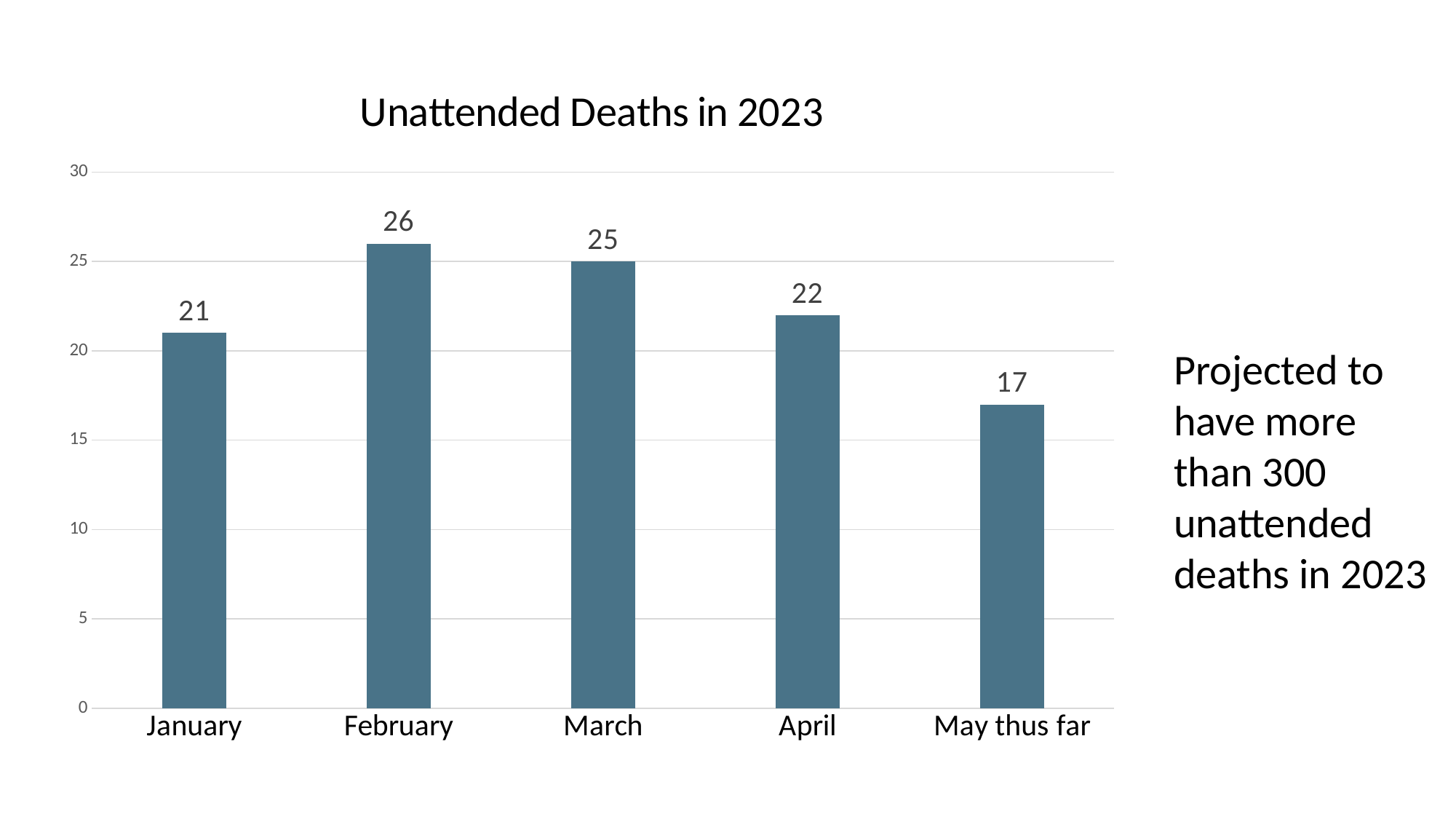
What is the value for April? 22 Which month has the highest number of unattended deaths? February Which is larger, the value for January or the value for April? April Is the value for March greater or less than 20? greater What is the difference between the values for March and May thus far? 8 What is the difference between the values for February and January? 5 Which category has the lowest value? May thus far How many categories are shown on the x axis? 5 What is the value for May thus far? 17 What is the title of the chart? Unattended Deaths in 2023 What is the value for February? 26 What kind of chart is shown on the slide? Bar chart